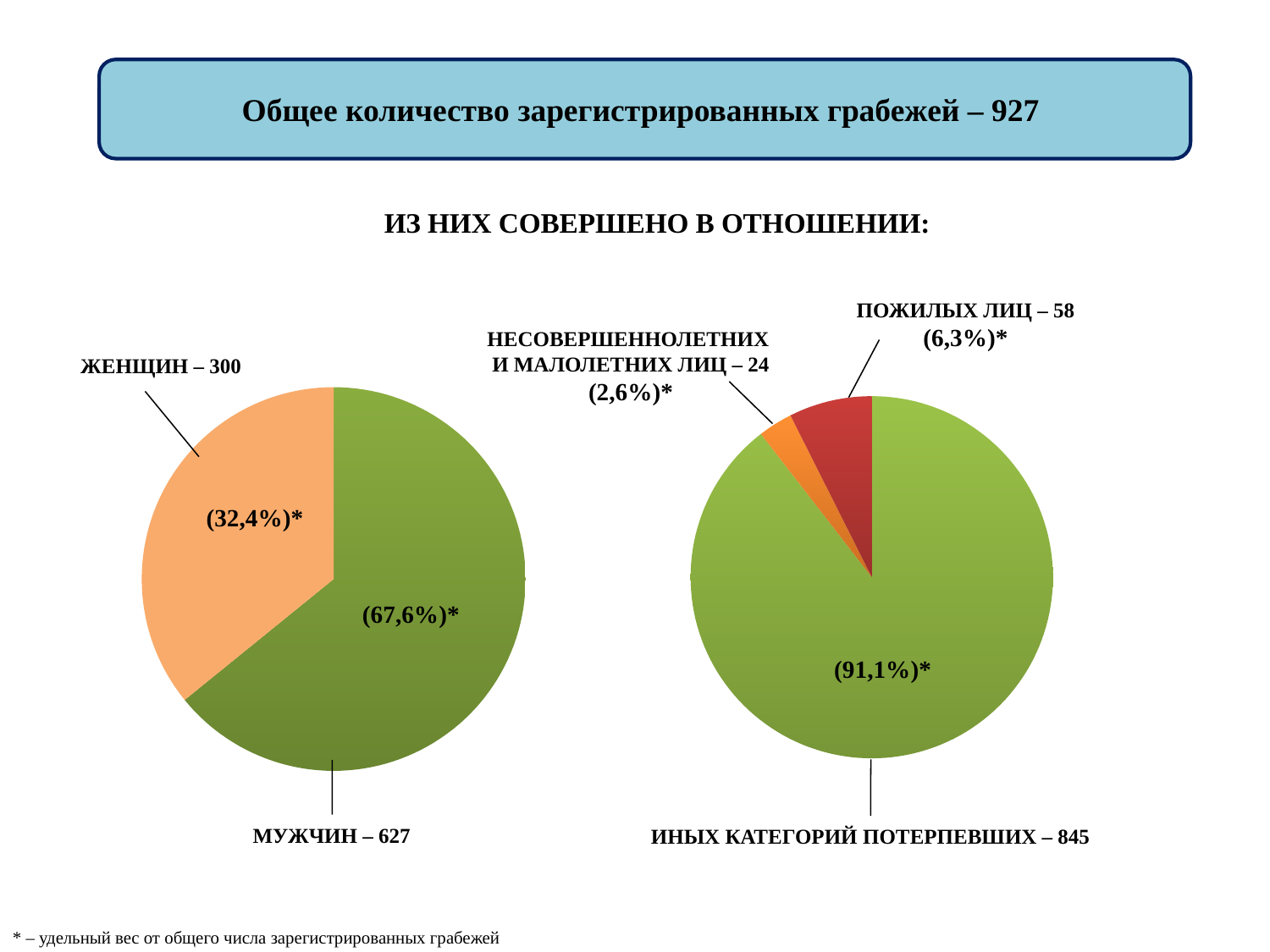
On the right pie chart, how many robberies were committed against minors and juveniles (НЕСОВЕРШЕННОЛЕТНИХ И МАЛОЛЕТНИХ ЛИЦ)? 24 On the left pie chart, how many robberies were committed against men (МУЖЧИН)? 627 On the right pie chart, which category has the smallest slice? НЕСОВЕРШЕННОЛЕТНИХ И МАЛОЛЕТНИХ ЛИЦ On the right pie chart, what share of the total do robberies against other categories of victims (ИНЫХ КАТЕГОРИЙ ПОТЕРПЕВШИХ) represent? 91,1% On the left pie chart, how many robberies were committed against women (ЖЕНЩИН)? 300 On the left pie chart, what share of the total do robberies against men (МУЖЧИН) represent? 67,6% On the left pie chart, what is the difference between the number of robberies against men and against women? 327 On the right pie chart, which category has the largest slice? ИНЫХ КАТЕГОРИЙ ПОТЕРПЕВШИХ What type of chart is used on the left side of the slide? Pie chart On the left pie chart, what share of the total do robberies against women (ЖЕНЩИН) represent? 32,4% On the right pie chart, how many slices are there? 3 On the right pie chart, how many robberies were committed against elderly persons (ПОЖИЛЫХ ЛИЦ)? 58